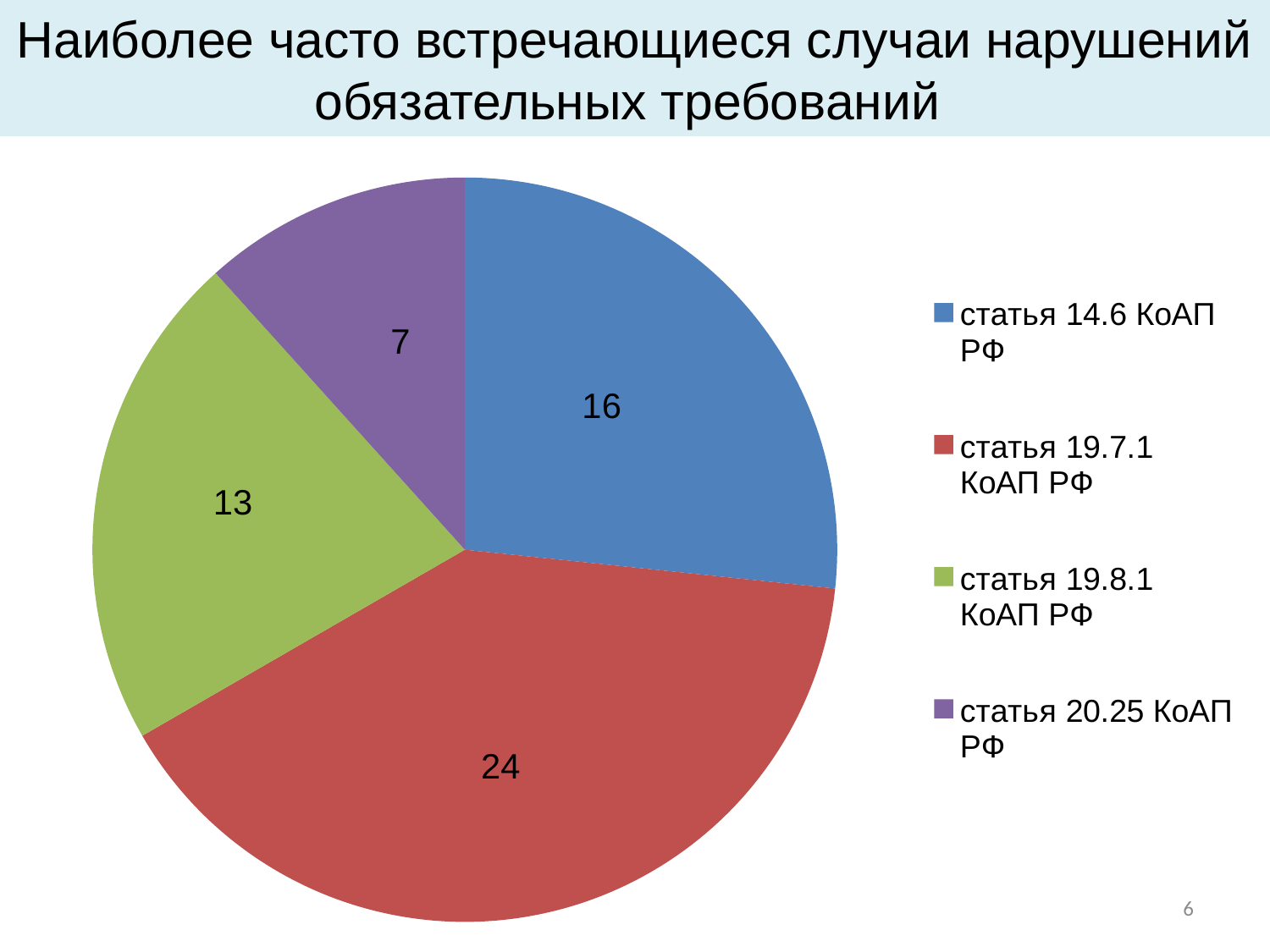
What colour is the slice for статья 19.8.1 КоАП РФ? green What type of chart is shown on the slide? pie chart Which category has the largest slice of the pie? статья 19.7.1 КоАП РФ Which is larger, the value for статья 19.8.1 КоАП РФ or the value for статья 20.25 КоАП РФ? статья 19.8.1 КоАП РФ What share of the pie does статья 19.7.1 КоАП РФ represent? 40% What is the value for статья 20.25 КоАП РФ? 7 What is the value for статья 14.6 КоАП РФ? 16 What is the difference between the values for статья 19.7.1 КоАП РФ and статья 14.6 КоАП РФ? 8 What is the value for статья 19.8.1 КоАП РФ? 13 What is the value for статья 19.7.1 КоАП РФ? 24 How many categories does the pie chart have? 4 Which category has the smallest slice of the pie? статья 20.25 КоАП РФ